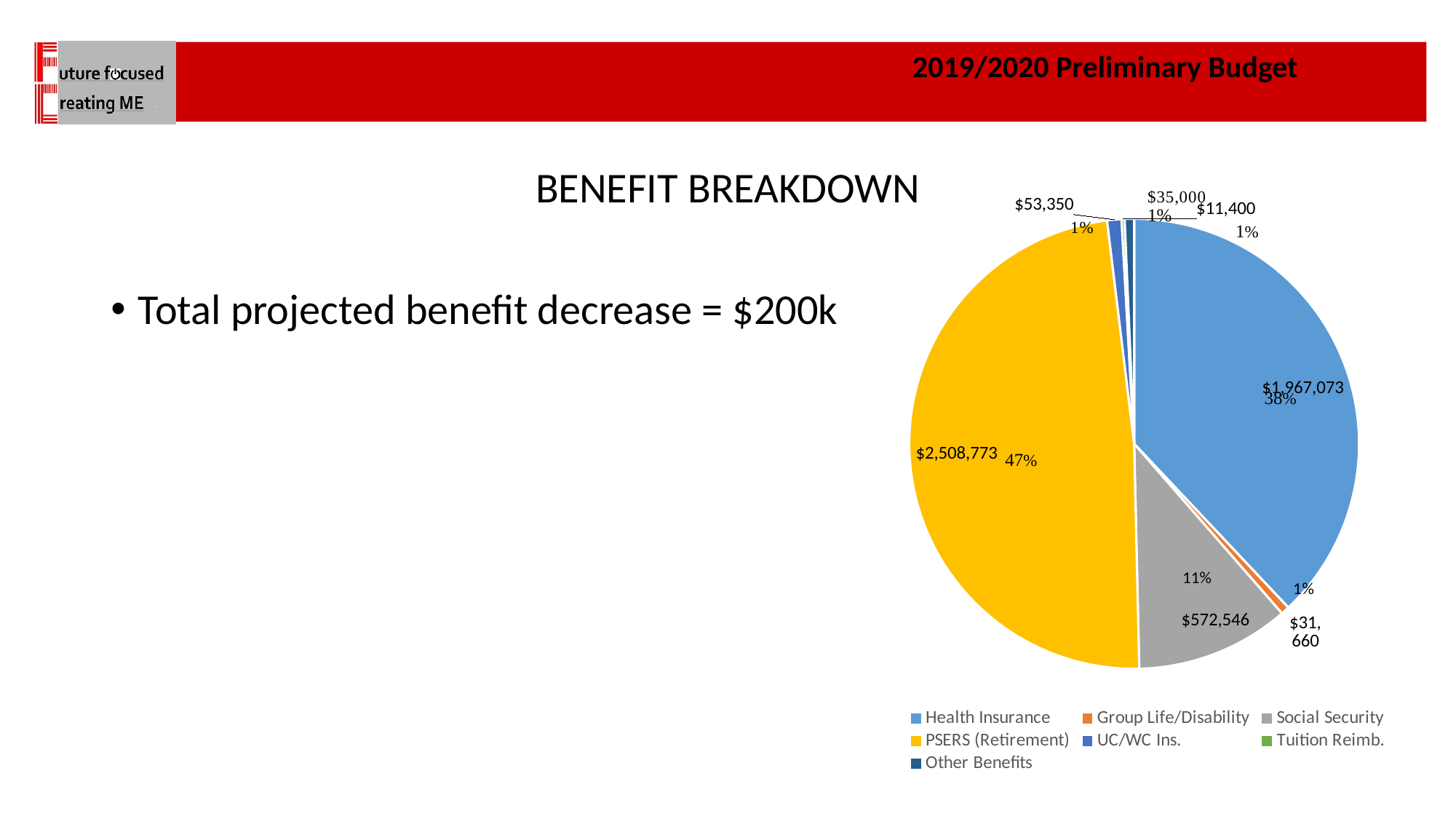
What is the value for Social Security in the pie chart? $572,546 What is the value for UC/WC Ins. in the pie chart? $53,350 What kind of chart is shown on the slide? pie chart What share of the pie does Health Insurance represent? 38% How many categories does the legend of the pie chart list? 7 Which is larger, Health Insurance or Social Security? Health Insurance What share of the pie does Social Security represent? 11% What is the value for PSERS (Retirement) in the pie chart? $2,508,773 What is the value for Group Life/Disability in the pie chart? $31,660 What is the value for Health Insurance in the pie chart? $1,967,073 What share of the pie does PSERS (Retirement) represent? 47% Which category has the largest slice of the pie? PSERS (Retirement)